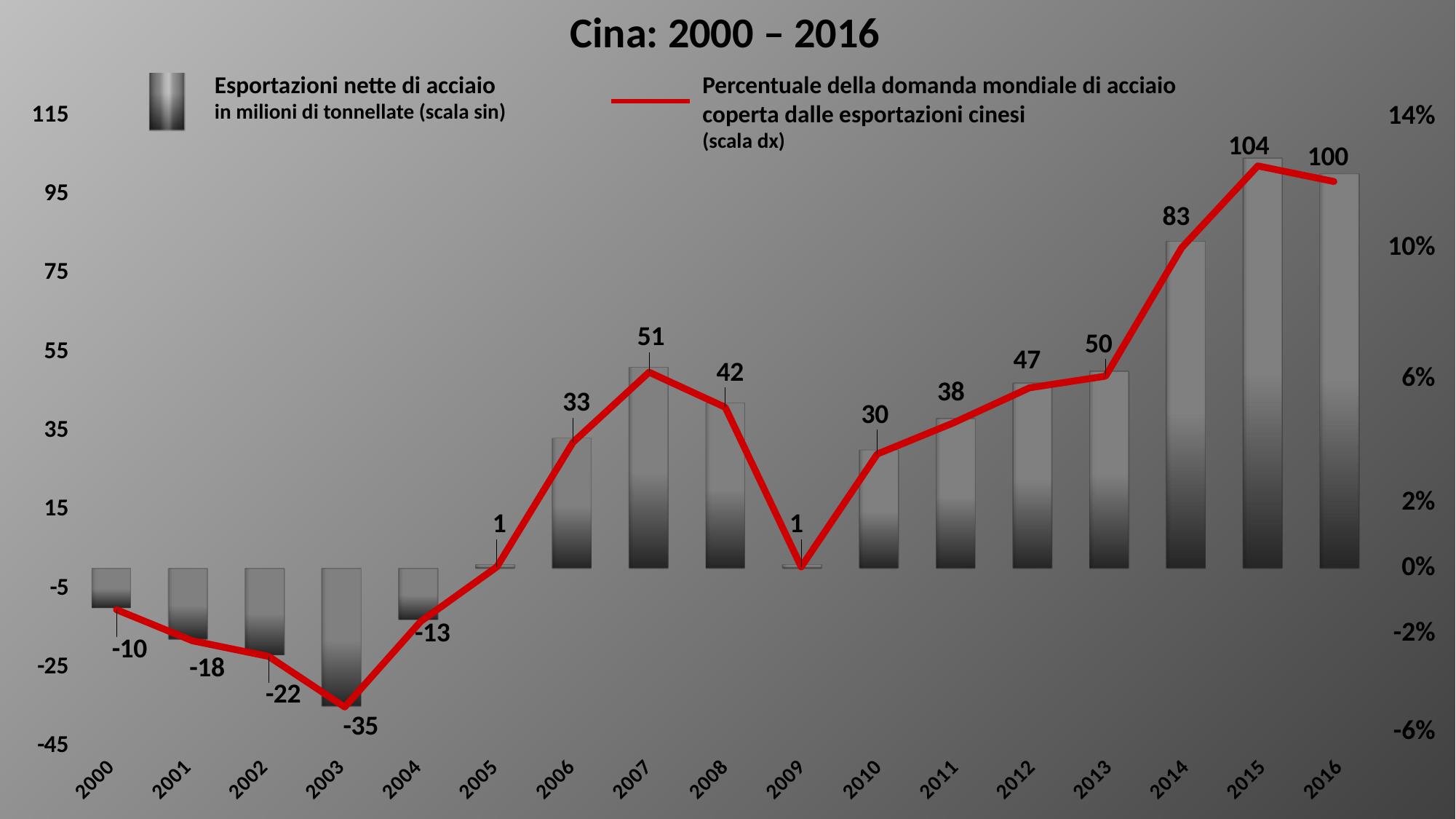
Which year has the lowest net steel export bar? 2003 Is the percentage of world steel demand covered by Chinese exports in 2010 greater or less than 2%? greater What is the net steel export value shown for 2009? 1 How many years are shown on the x axis? 17 Which year has a larger net steel export value, 2007 or 2008? 2007 How many series does the legend list? 2 Which year has the highest net steel export bar? 2015 What is the net steel export value shown for 2003? -35 What is the difference between the net steel export values for 2015 and 2016? 4 What kind of chart is shown on the slide? Combined bar and line chart Is the percentage of world steel demand covered by Chinese exports in 2015 greater or less than 10%? greater What is the net steel export value shown for 2015? 104